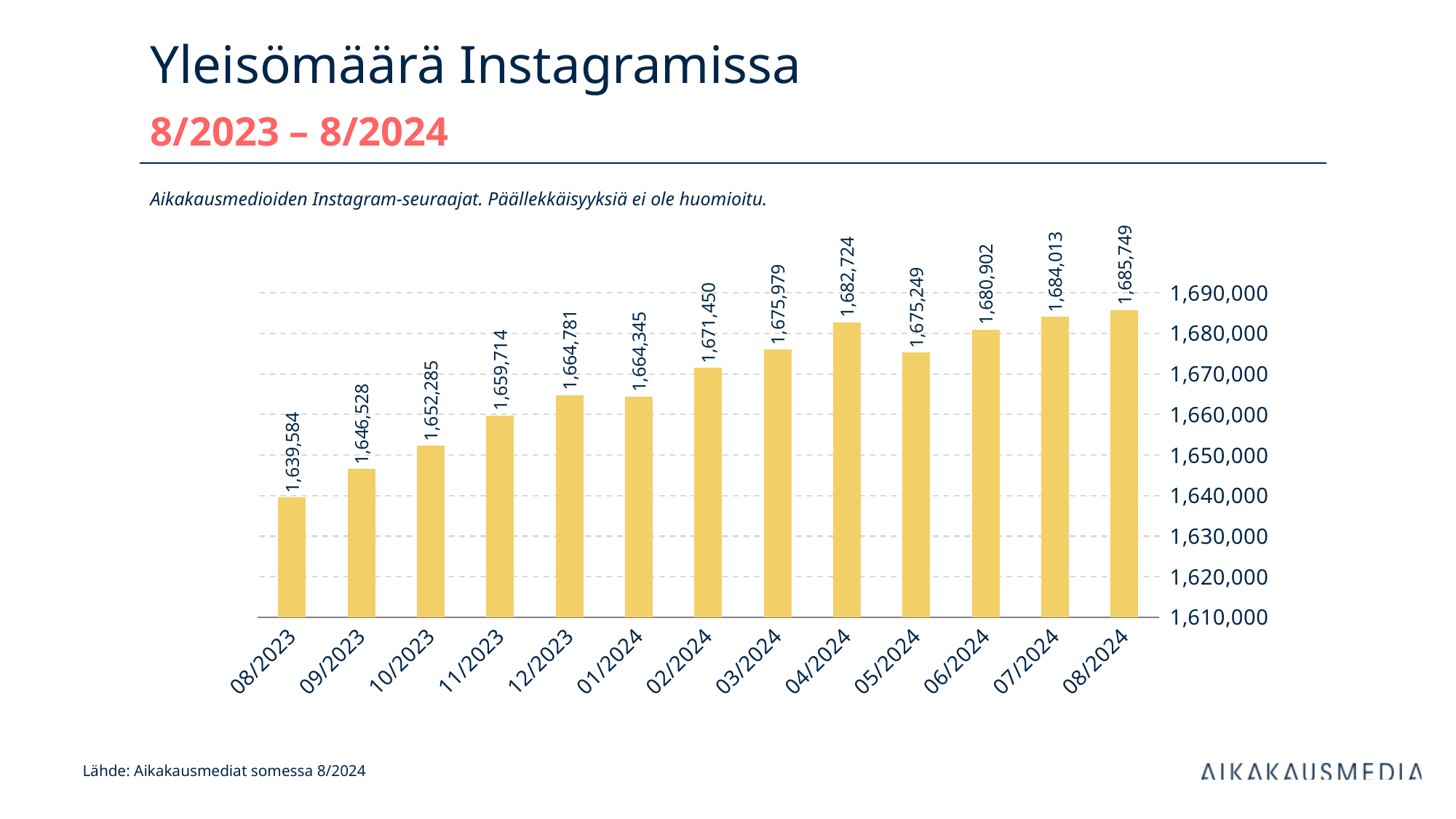
What is the difference between the values for 08/2024 and 08/2023? 46,165 Which is larger, the value for 04/2024 or the value for 05/2024? 04/2024 What is the value for 01/2024? 1,664,345 What is the difference between the values for 04/2024 and 05/2024? 7,475 What is the value for 08/2023? 1,639,584 What kind of chart is shown on the slide? bar chart Is the value for 03/2024 greater or less than 1,680,000? less Which month has the lowest value? 08/2023 How many months are shown on the x axis? 13 What is the value for 04/2024? 1,682,724 What is the title of the chart on the slide? Yleisömäärä Instagramissa Which month has the highest value? 08/2024